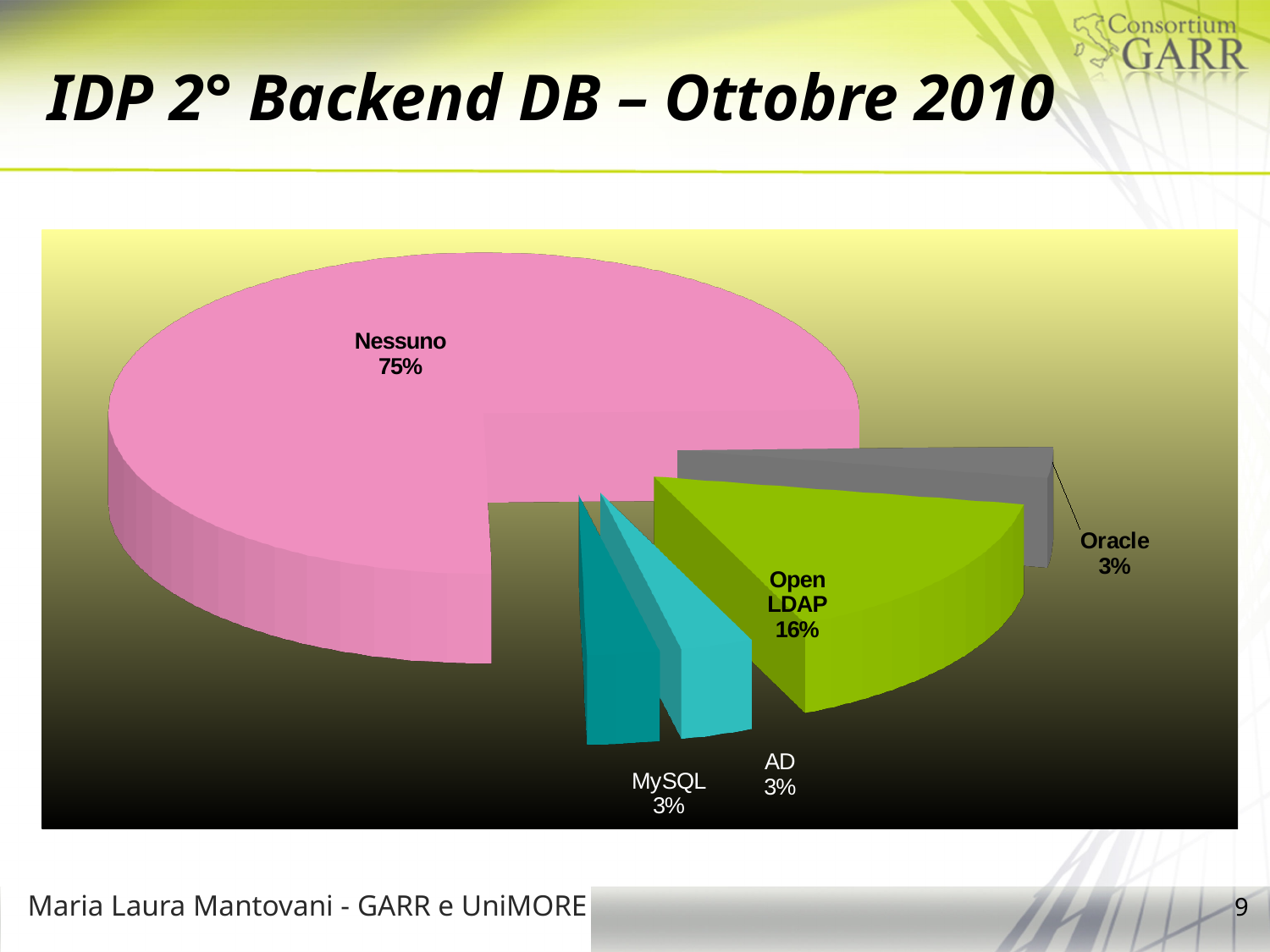
What share of the pie does Open LDAP have? 16% What share of the pie does AD have? 3% What is the title of the slide containing the pie chart? IDP 2° Backend DB – Ottobre 2010 How many slices does the pie chart have? 5 Which is larger, the share for Open LDAP or the share for Oracle? Open LDAP Which category has the largest slice of the pie? Nessuno What colour is the Nessuno slice of the pie? pink What share of the pie does MySQL have? 3% What share of the pie does Oracle have? 3% What share of the pie does Nessuno have? 75% What is the difference in percentage points between Nessuno and Open LDAP? 59 What kind of chart is shown on the slide? pie chart